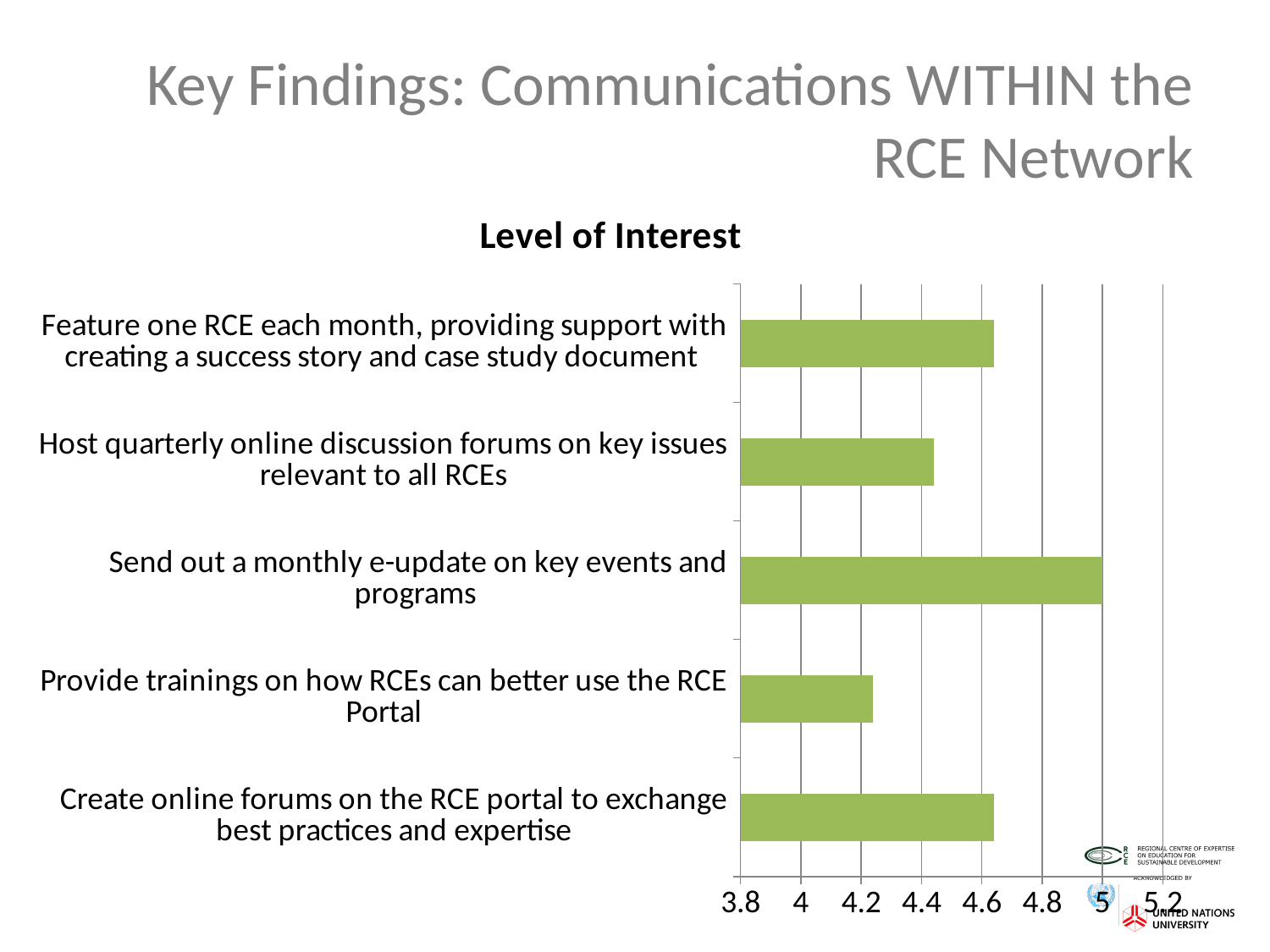
Is the value for 'Host quarterly online discussion forums on key issues relevant to all RCEs' greater or less than 4.6? less Which category has the lowest level of interest? Provide trainings on how RCEs can better use the RCE Portal What type of chart is shown on the slide? bar chart Which has a higher level of interest: 'Host quarterly online discussion forums on key issues relevant to all RCEs' or 'Provide trainings on how RCEs can better use the RCE Portal'? Host quarterly online discussion forums on key issues relevant to all RCEs How many categories are plotted in the chart? 5 Is the value for 'Create online forums on the RCE portal to exchange best practices and expertise' greater or less than 4.4? greater What is the title of the chart? Level of Interest Which has a higher level of interest: 'Send out a monthly e-update on key events and programs' or 'Create online forums on the RCE portal to exchange best practices and expertise'? Send out a monthly e-update on key events and programs Is the value for 'Feature one RCE each month, providing support with creating a success story and case study document' greater or less than 4.4? greater Which category has the highest level of interest? Send out a monthly e-update on key events and programs What is the level of interest for 'Send out a monthly e-update on key events and programs'? 5